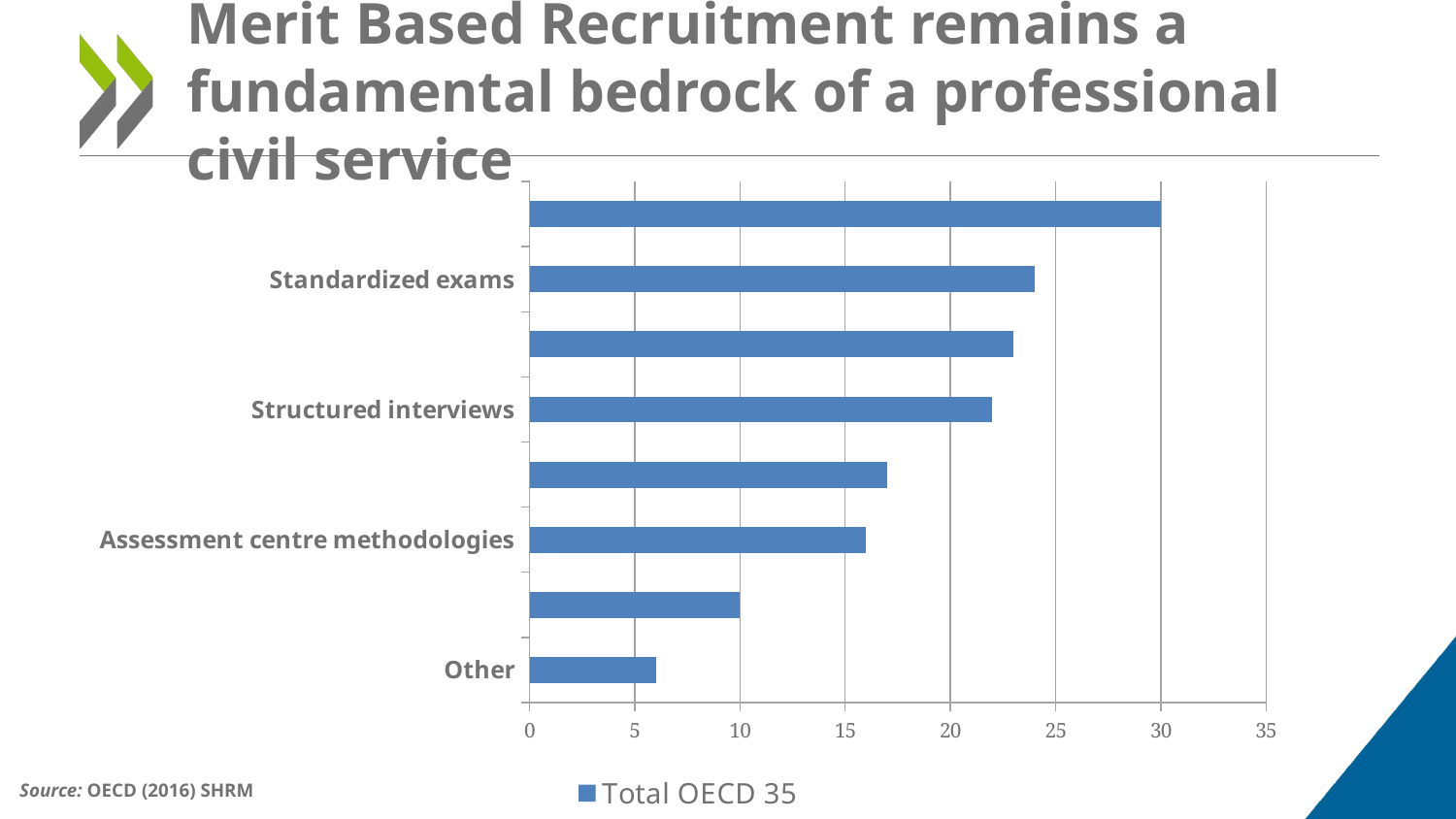
Which has the larger value, Standardized exams or Assessment centre methodologies? Standardized exams Is the value for Standardized exams greater or less than 20? greater How many series does the legend list? 1 Of the labelled categories, which has the lowest value? Other Is the value for Other greater or less than 10? less How many bars are plotted in the chart? 8 Which has the larger value, Structured interviews or Other? Structured interviews Is the value for Standardized exams greater or less than 25? less What kind of chart is shown on the slide? bar chart What is the name of the series shown in the legend? Total OECD 35